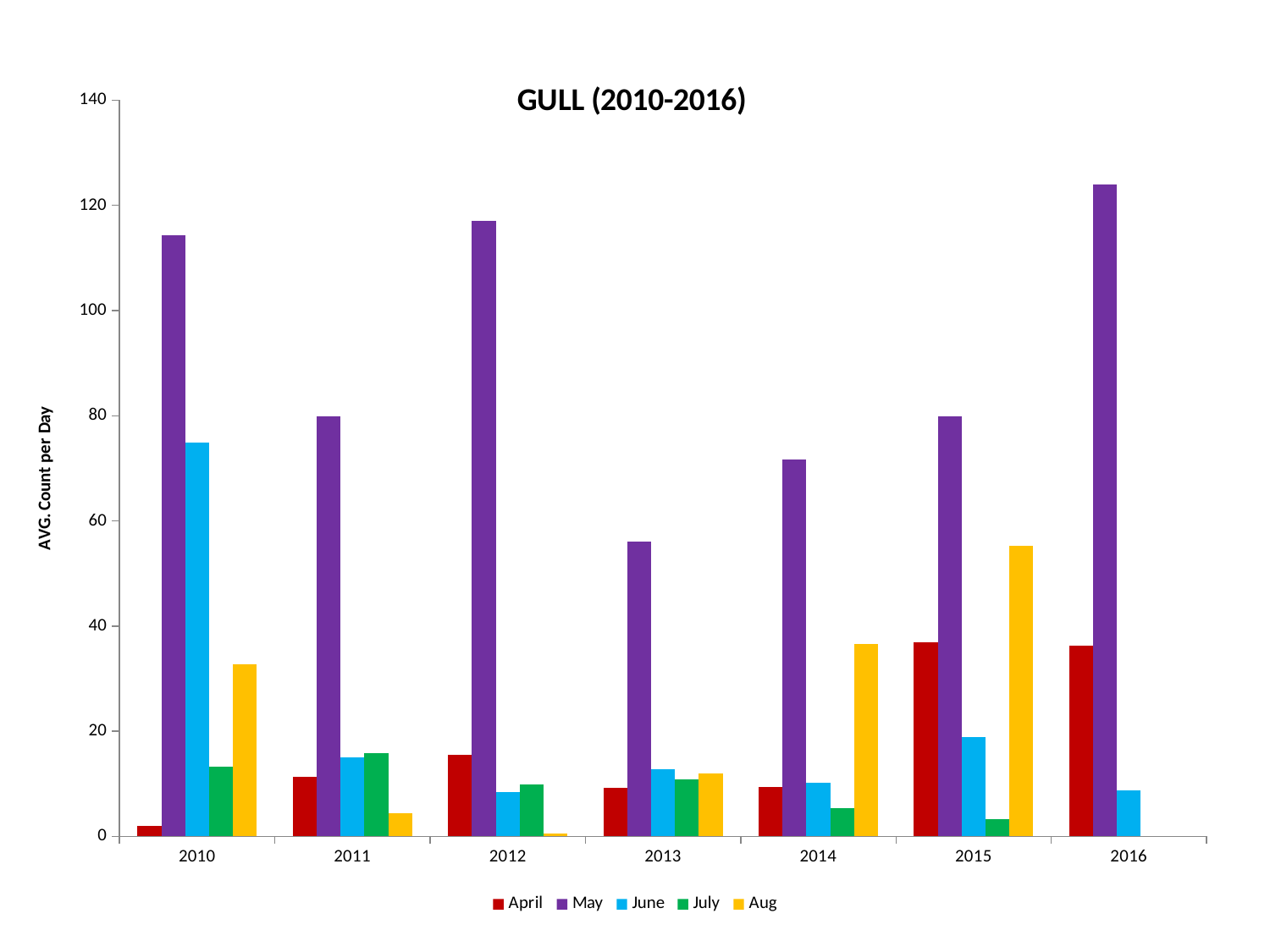
How many series does the legend list? 5 What is the title of the y axis? AVG. Count per Day Is the May value for 2016 greater or less than 120? greater Which is larger, the May value for 2011 or the May value for 2014? 2011 In 2010, which month has the lowest value? April Is the Aug value for 2015 greater or less than 40? greater Which is larger, the Aug value for 2014 or the Aug value for 2015? 2015 Which year has the lowest May value? 2013 What kind of chart is shown on the slide? bar chart How many years are shown along the x axis? 7 Is the June value for 2010 greater or less than 60? greater Which year has the highest May value? 2016